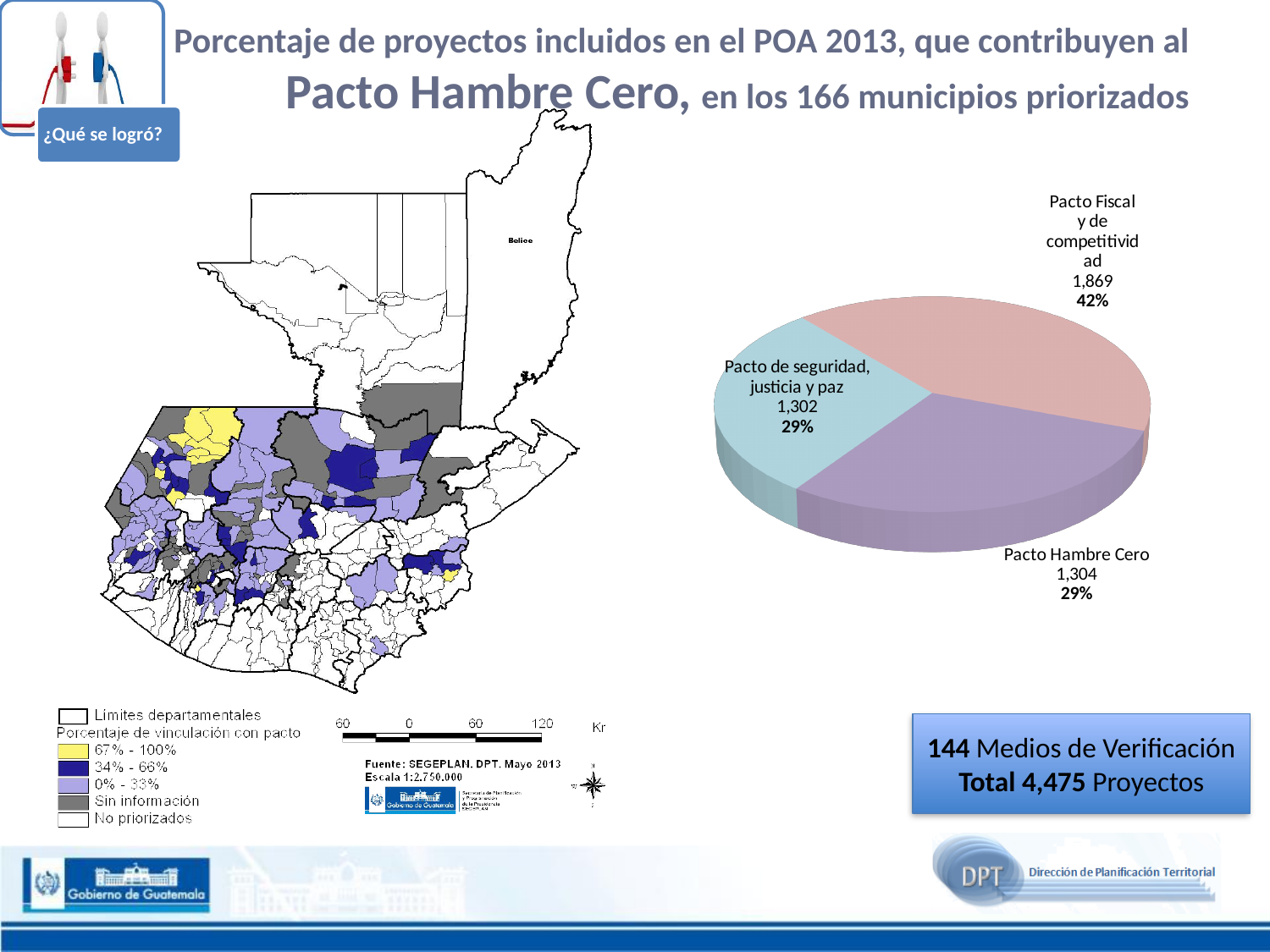
What is the value shown for Pacto Hambre Cero in the pie chart? 1,304 Which category has the smallest value in the pie chart? Pacto de seguridad, justicia y paz What share of the pie does Pacto Fiscal y de competitividad represent? 42% What kind of chart is shown on the right side of the slide? pie chart How many slices does the pie chart have? 3 Which category has the largest slice in the pie chart? Pacto Fiscal y de competitividad What is the difference between the values for Pacto Fiscal y de competitividad and Pacto Hambre Cero? 565 What is the total of the three values shown in the pie chart? 4,475 What is the value shown for Pacto Fiscal y de competitividad in the pie chart? 1,869 What share of the pie does Pacto Hambre Cero represent? 29% Which is larger in the pie chart: Pacto Fiscal y de competitividad or Pacto de seguridad, justicia y paz? Pacto Fiscal y de competitividad What is the value shown for Pacto de seguridad, justicia y paz in the pie chart? 1,302